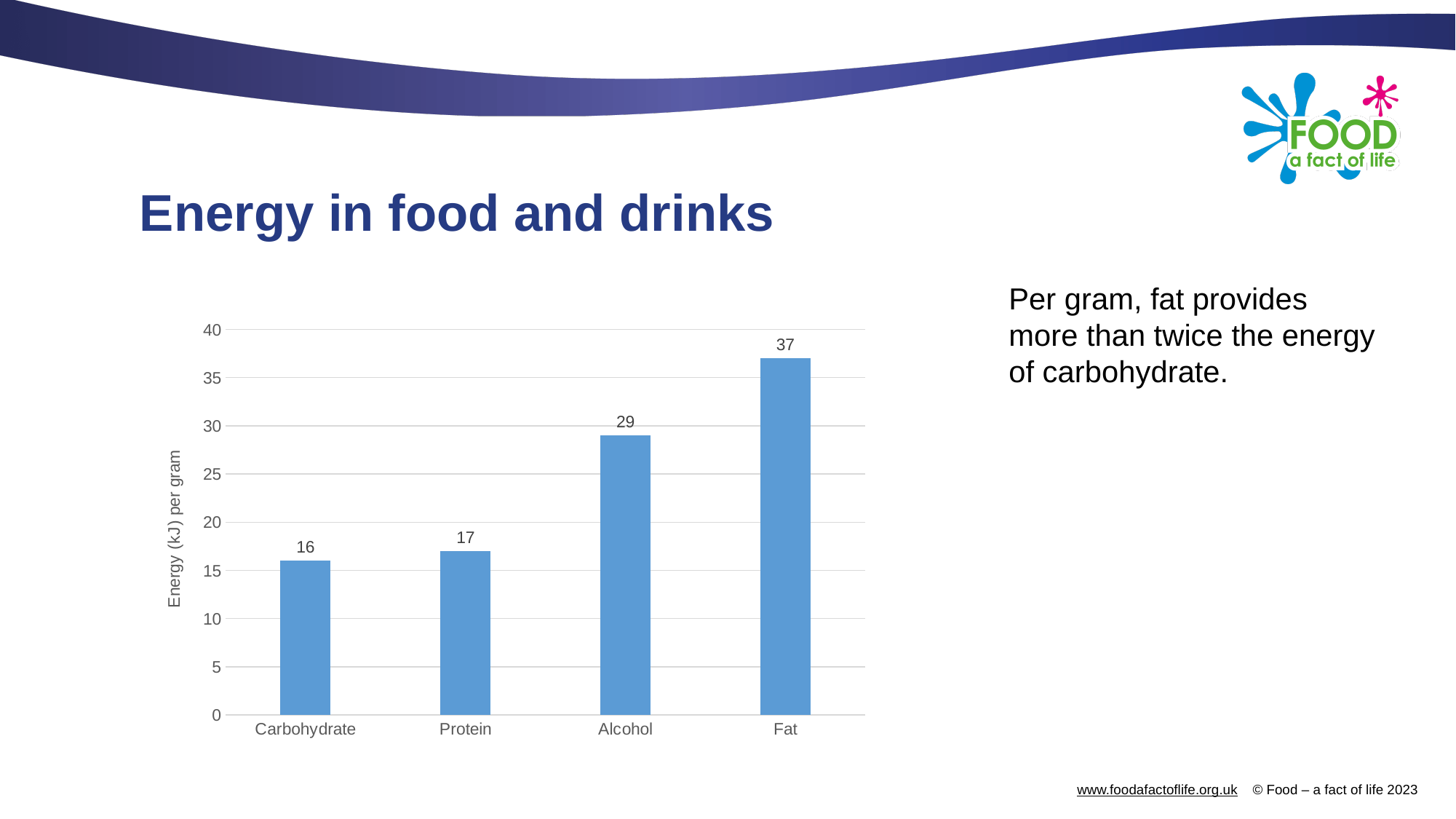
What type of chart is shown on the slide? Bar chart What is the energy per gram for Carbohydrate? 16 How many categories are shown in the chart? 4 Which has a higher energy per gram, Alcohol or Protein? Alcohol What is the energy per gram for Alcohol? 29 Is the value for Alcohol greater or less than 25? greater Which category has the highest energy per gram? Fat Which category has the lowest energy per gram? Carbohydrate What is the difference in energy per gram between Alcohol and Protein? 12 What is the energy per gram for Fat? 37 What is the energy per gram for Protein? 17 What is the difference in energy per gram between Fat and Carbohydrate? 21